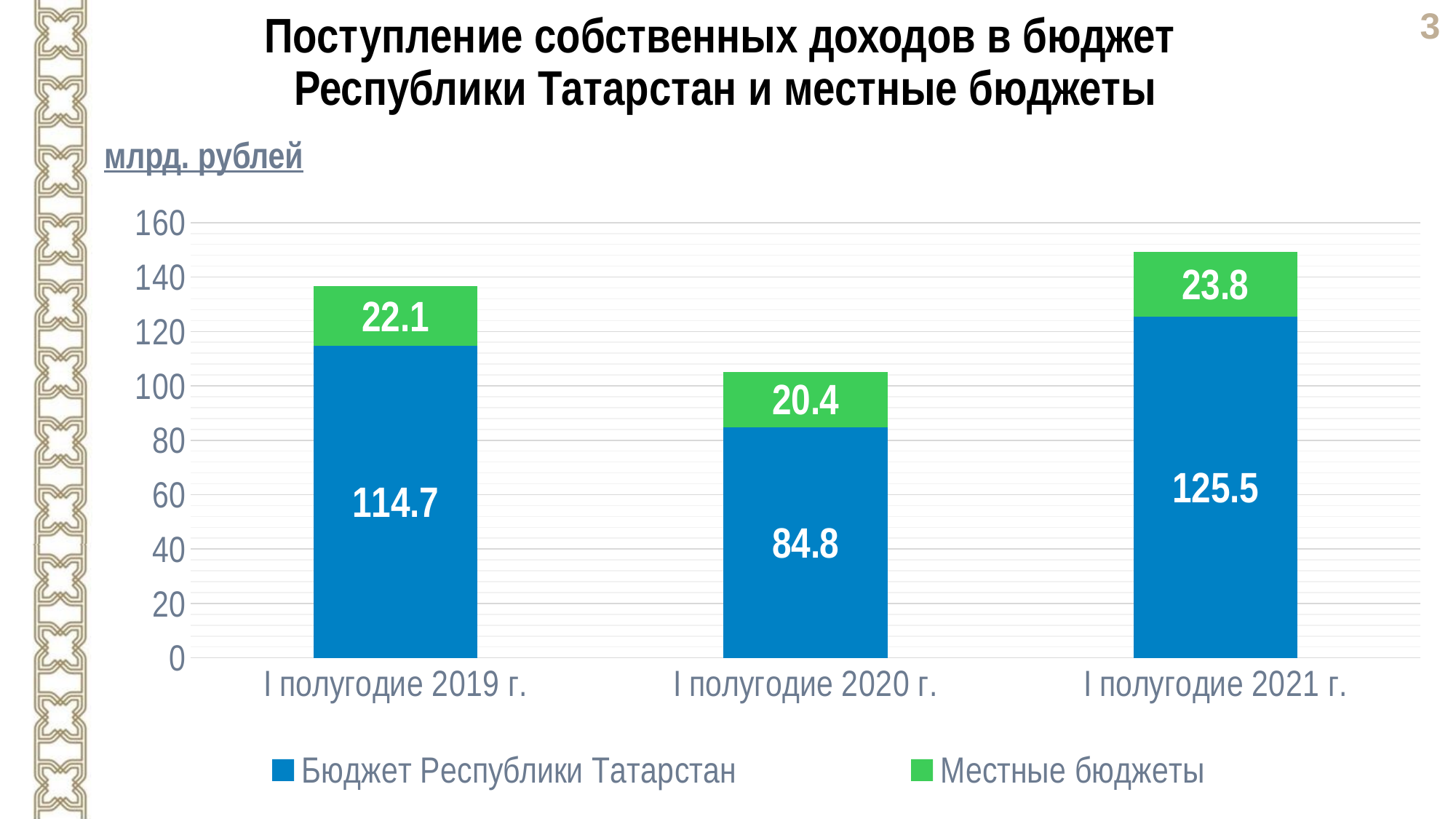
How many series does the legend list? 2 How many periods are shown on the x axis? 3 What is the total of the stacked bar for I полугодие 2021 г.? 149.3 What is the total of the stacked bar for I полугодие 2019 г.? 136.8 What is the difference between the Бюджет Республики Татарстан values for I полугодие 2021 г. and I полугодие 2020 г.? 40.7 What is the value for Бюджет Республики Татарстан in I полугодие 2020 г.? 84.8 In which period is the value for Бюджет Республики Татарстан the highest? I полугодие 2021 г. In which period is the value for Местные бюджеты the lowest? I полугодие 2020 г. What kind of chart is shown on the slide? Stacked bar chart What is the value for Местные бюджеты in I полугодие 2021 г.? 23.8 Which is larger: the Местные бюджеты value for I полугодие 2019 г. or for I полугодие 2020 г.? I полугодие 2019 г. What is the value for Бюджет Республики Татарстан in I полугодие 2019 г.? 114.7